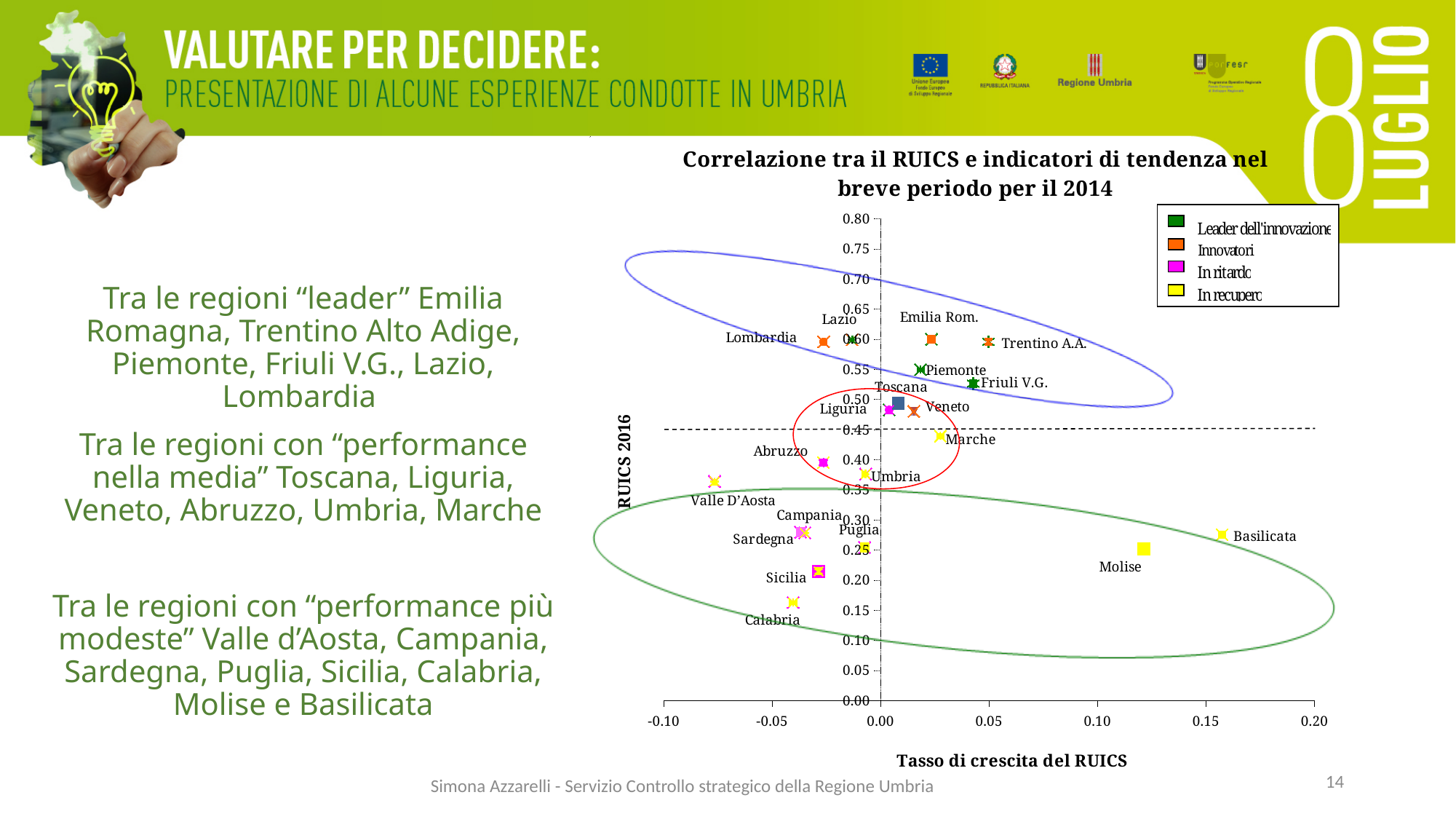
Which region has the lowest Tasso di crescita del RUICS (furthest left) on the chart? Valle D'Aosta What is the label of the horizontal axis of the chart? Tasso di crescita del RUICS Is the RUICS 2016 value for Friuli V.G. greater or less than 0.50? greater How many regions are plotted and labelled on the chart? 20 Which region has the highest Tasso di crescita del RUICS (furthest right) on the chart? Basilicata Is the RUICS 2016 value for Calabria greater or less than 0.20? less Is the Tasso di crescita del RUICS for Molise greater or less than 0.10? greater What kind of chart is shown on the slide? Scatter chart What is the title of the chart? Correlazione tra il RUICS e indicatori di tendenza nel breve periodo per il 2014 Which region has the lowest RUICS 2016 value on the chart? Calabria Which region has a higher RUICS 2016 value, Sicilia or Calabria? Sicilia How many entries does the chart legend list? 4